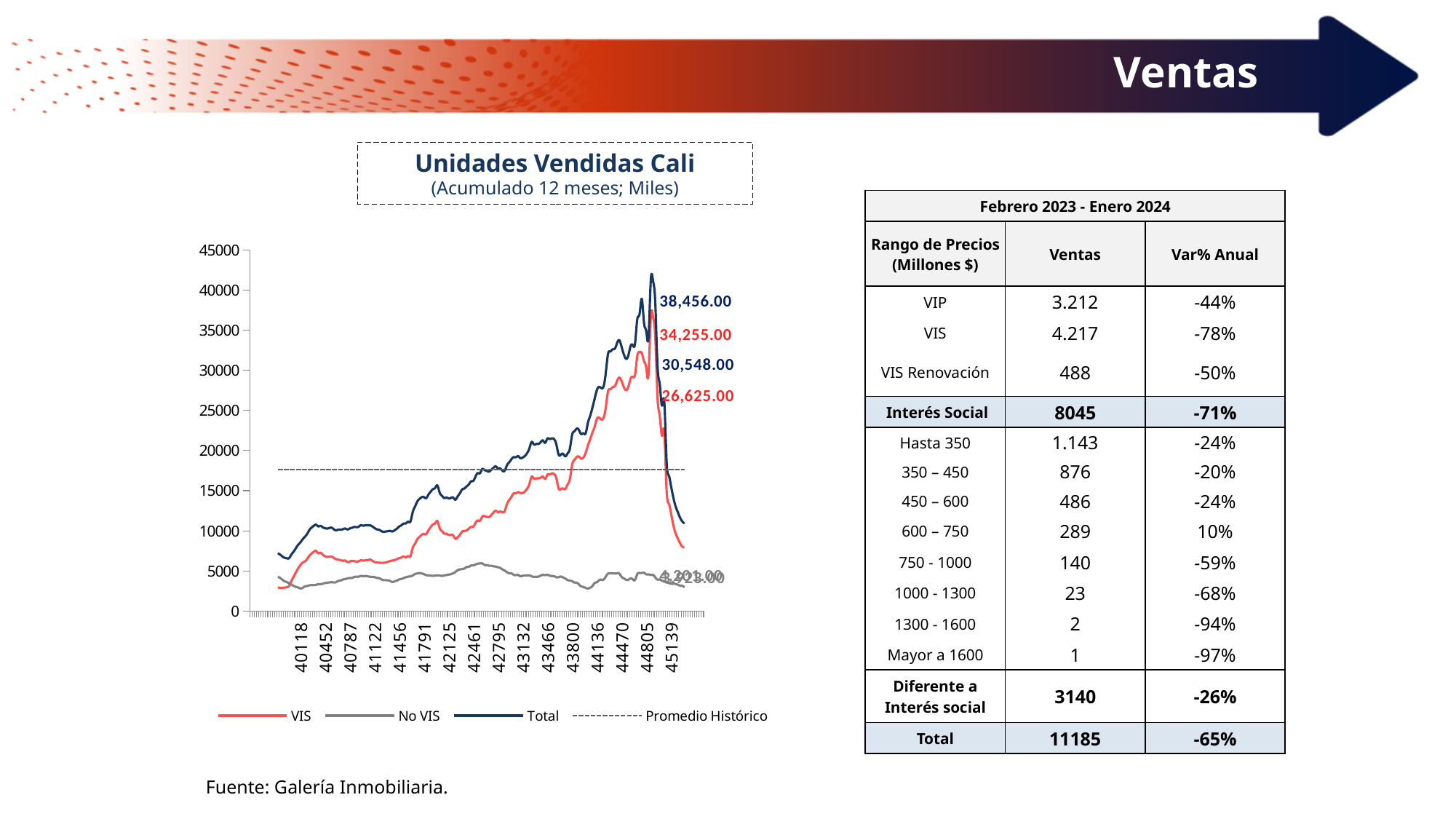
In the 'Unidades Vendidas Cali' chart, is the Promedio Histórico dashed line greater or less than 20000? less In the 'Unidades Vendidas Cali' chart, does the No VIS series ever exceed 10000? No How many series does the legend of the 'Unidades Vendidas Cali' chart list? 4 In the 'Unidades Vendidas Cali' chart, is the Promedio Histórico dashed line greater or less than 15000? greater In the 'Unidades Vendidas Cali' chart, how does the Total series behave at the far right end of the x axis? It falls sharply What are the legend entries of the 'Unidades Vendidas Cali' chart? VIS, No VIS, Total, Promedio Histórico In the 'Unidades Vendidas Cali' chart, which series reaches the highest values? Total In the 'Unidades Vendidas Cali' chart, what is the highest data label shown for the Total series? 38,456.00 What is the subtitle shown under the title 'Unidades Vendidas Cali'? (Acumulado 12 meses; Miles) What kind of chart is 'Unidades Vendidas Cali'? line chart